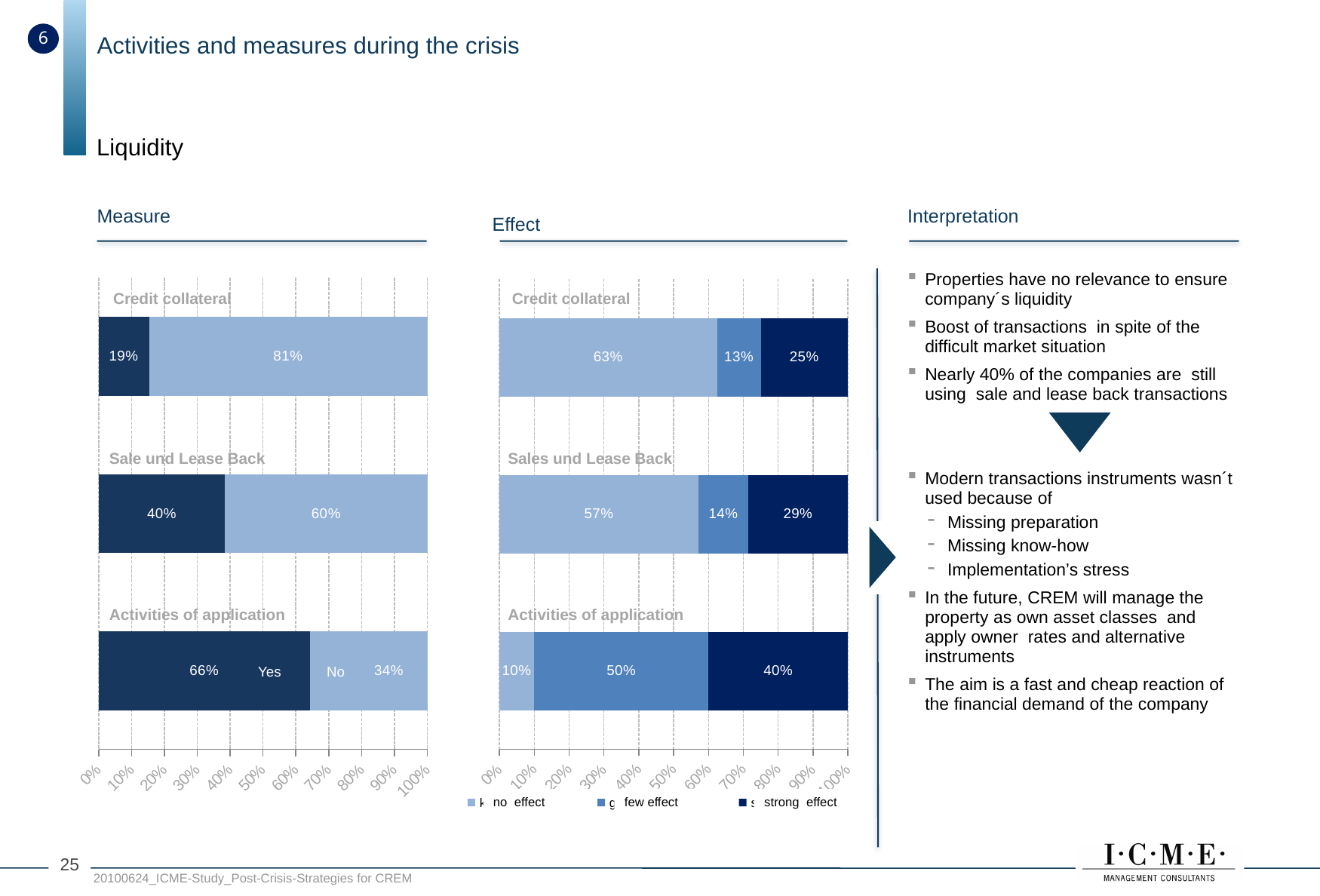
How many series does the legend of the Effect chart list? 3 In the Measure chart, what is the No share for Credit collateral? 81% In the Effect chart, which category has the lowest no-effect share? Activities of application In the Effect chart, is the strong-effect share larger for Activities of application or for Credit collateral? Activities of application In the Effect chart, what share reported a strong effect for Sales und Lease Back? 29% In the Effect chart, what share reported no effect for Activities of application? 10% In the Measure chart, what is the difference between the Yes shares for Activities of application and Credit collateral? 47% What type of chart is the Measure chart? Stacked bar chart In the Effect chart, what is the total of the three segments for Credit collateral? 101% In the Measure chart, what percentage of companies answered Yes for Sale und Lease Back? 40% In the Measure chart, which category has the highest Yes share? Activities of application How many categories are shown in the Effect chart? 3